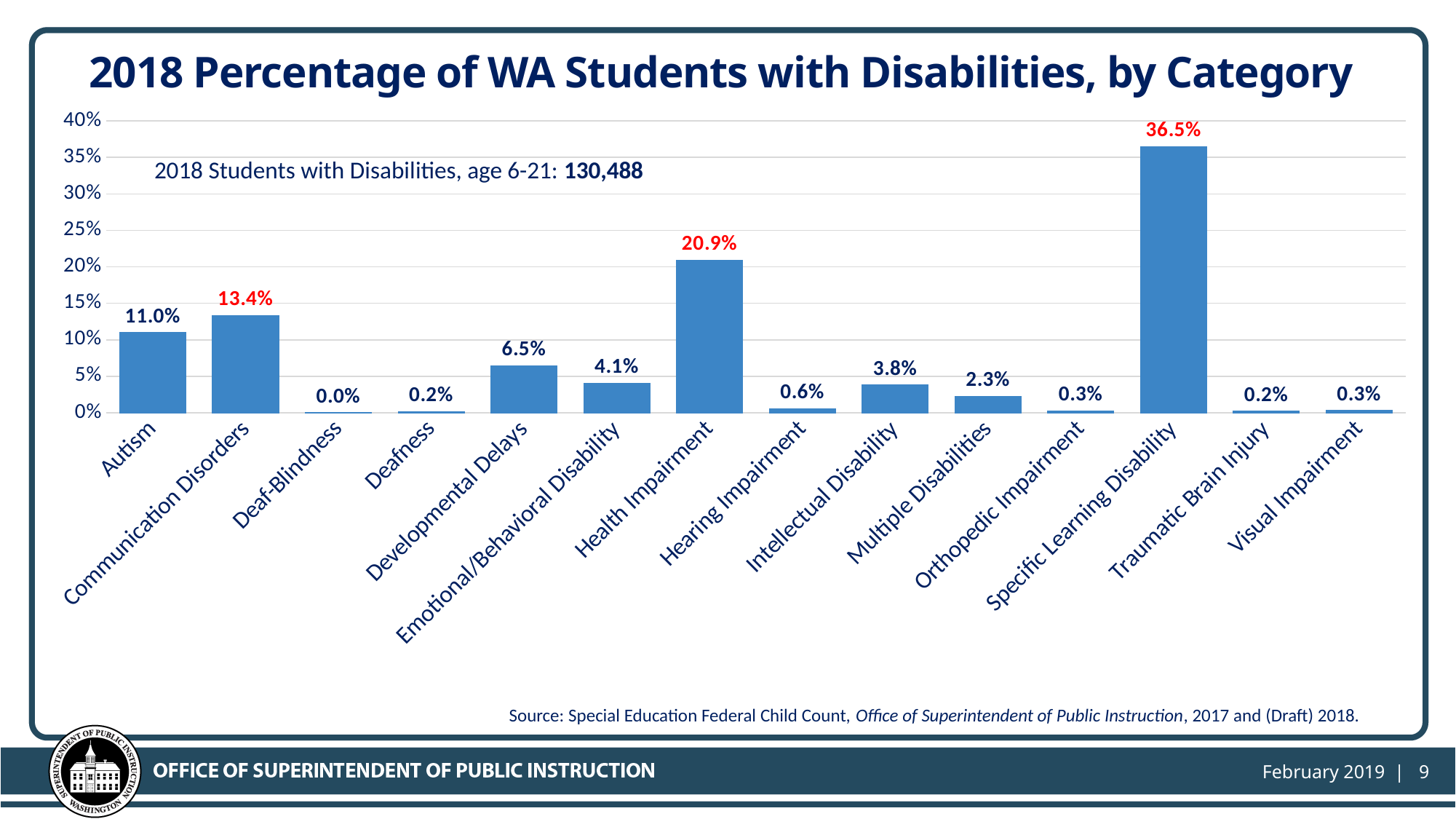
What is the percentage for Health Impairment? 20.9% What is the total number of 2018 students with disabilities, age 6-21, stated on the slide? 130,488 What is the percentage for Emotional/Behavioral Disability? 4.1% What is the title of the chart? 2018 Percentage of WA Students with Disabilities, by Category What kind of chart is shown on the slide? Bar chart What is the difference between the percentages for Communication Disorders and Autism? 2.4% Which is larger, the percentage for Developmental Delays or for Intellectual Disability? Developmental Delays What is the percentage for Specific Learning Disability? 36.5% How many categories are shown on the x axis? 14 Which category has the highest percentage? Specific Learning Disability Which category has the lowest percentage? Deaf-Blindness Is the value for Health Impairment greater or less than 20%? greater